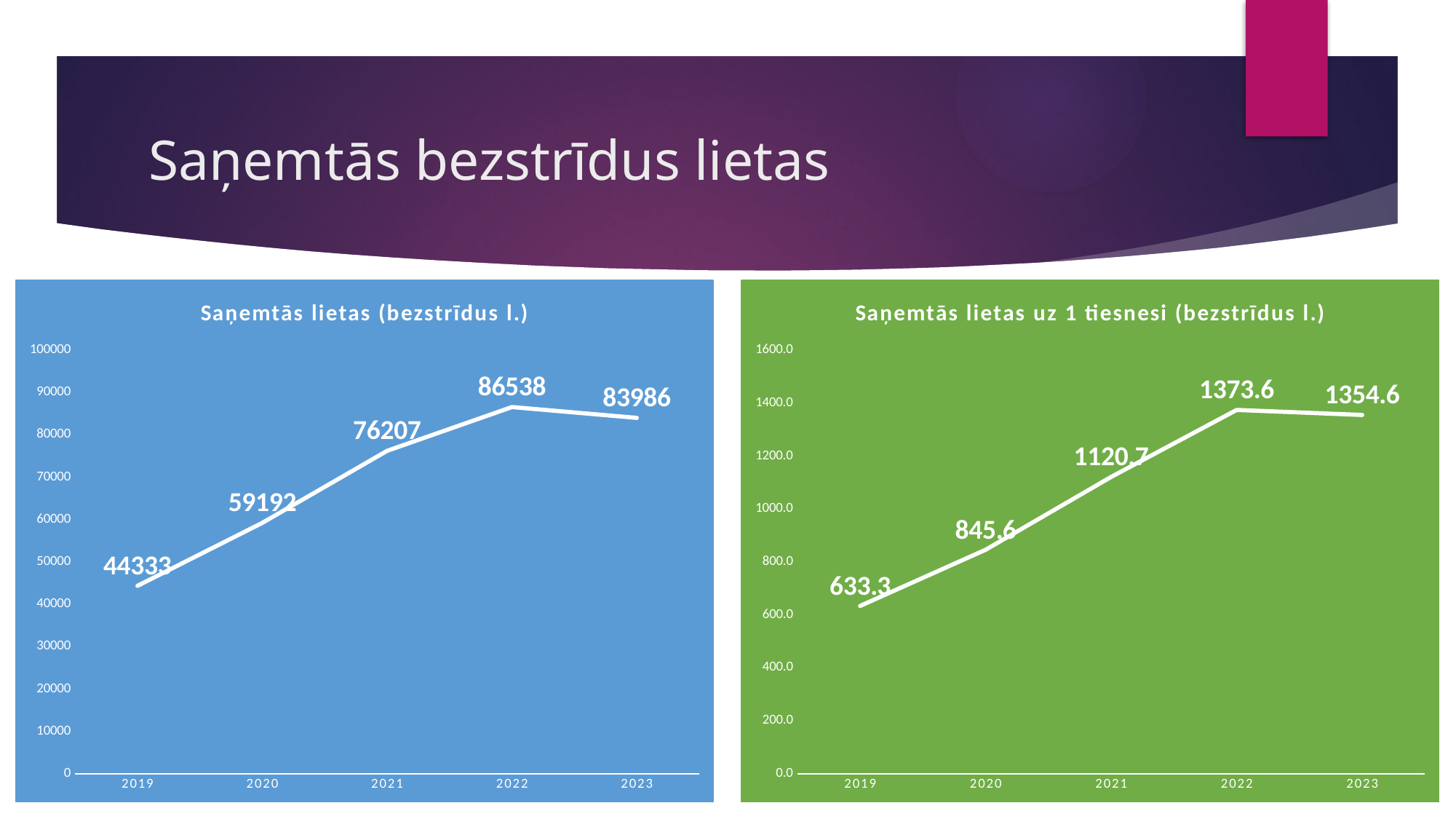
In the chart 'Saņemtās lietas uz 1 tiesnesi (bezstrīdus l.)', is the value for 2022 greater or less than 1200.0? greater How many years are plotted in the chart 'Saņemtās lietas (bezstrīdus l.)'? 5 In the chart 'Saņemtās lietas (bezstrīdus l.)', which is larger, the value for 2020 or the value for 2021? 2021 What kind of chart is 'Saņemtās lietas uz 1 tiesnesi (bezstrīdus l.)'? line chart In the chart 'Saņemtās lietas uz 1 tiesnesi (bezstrīdus l.)', which year has the lowest value? 2019 In the chart 'Saņemtās lietas (bezstrīdus l.)', what is the value for 2021? 76207 In the chart 'Saņemtās lietas uz 1 tiesnesi (bezstrīdus l.)', what is the value for 2020? 845.6 In the chart 'Saņemtās lietas (bezstrīdus l.)', which year has the highest value? 2022 In the chart 'Saņemtās lietas (bezstrīdus l.)', do the values rise or fall from 2019 to 2022? rise In the chart 'Saņemtās lietas uz 1 tiesnesi (bezstrīdus l.)', what is the difference between the values for 2021 and 2020? 275.1 What is the background colour of the chart on the right side of the slide? green In the chart 'Saņemtās lietas (bezstrīdus l.)', what is the difference between the values for 2022 and 2023? 2552